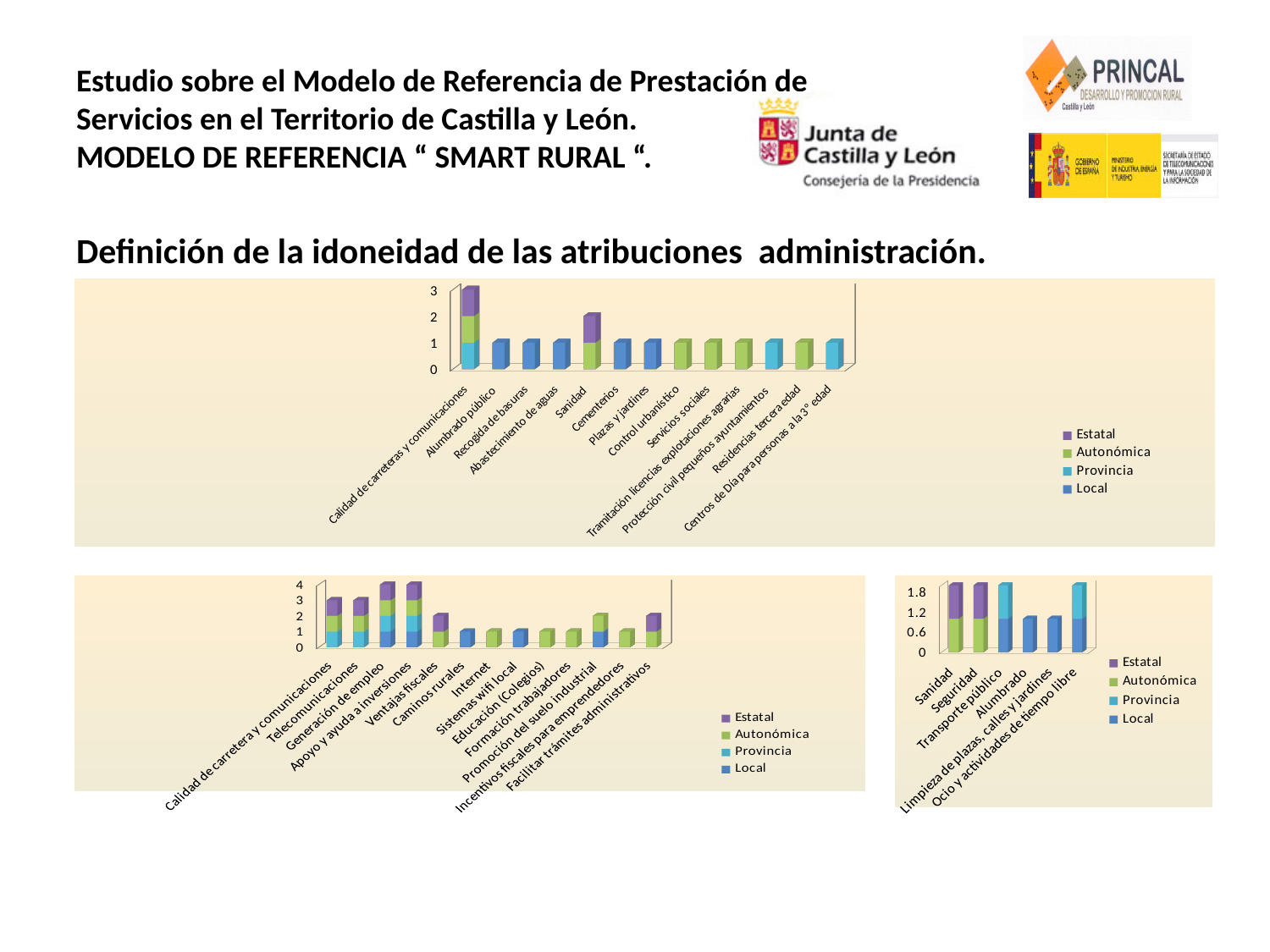
In the top chart, how many categories are shown on the x axis? 13 In the top chart, is the total for Cementerios greater or less than 2? less In the top chart, which category has the tallest stacked bar? Calidad de carreteras y comunicaciones In the top chart, is the total for Sanidad greater or less than 1? greater How many charts are on the slide? 3 In the bottom-left chart, which is larger, the total for Telecomunicaciones or the total for Internet? Telecomunicaciones In the bottom-right chart, is the total for Alumbrado greater or less than 1.8? less In the bottom-right chart, how many categories are shown on the x axis? 6 In the top chart, how many series does the legend list? 4 In the bottom-right chart, which series is listed first in the legend? Estatal What type of chart is the bottom-left chart? Stacked bar chart